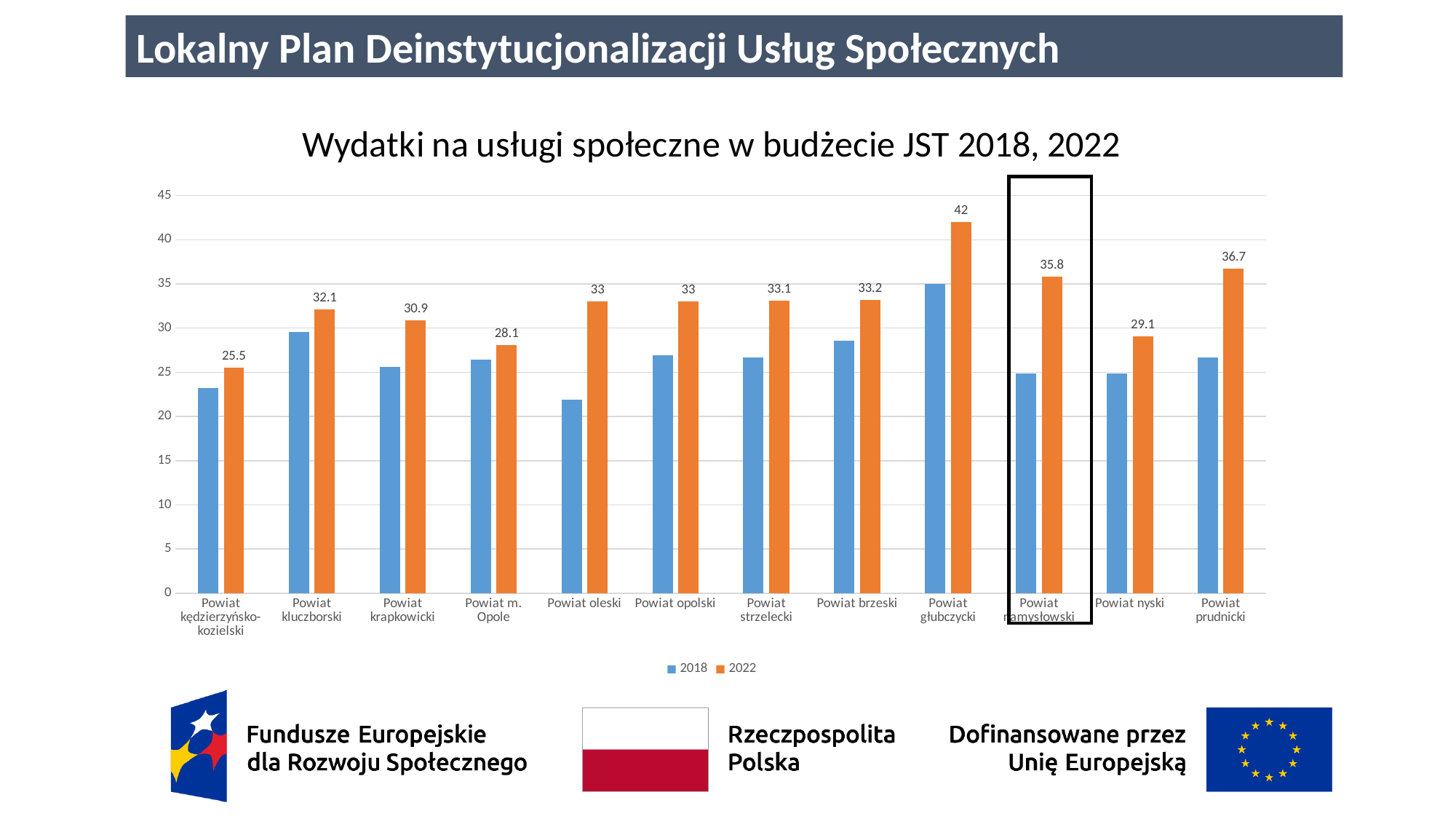
What is the difference between the 2022 values for Powiat prudnicki and Powiat nyski? 7.6 What is the 2022 value for Powiat kędzierzyńsko-kozielski? 25.5 What is the 2022 value for Powiat głubczycki? 42 How many categories (powiats) are shown on the x axis? 12 Which category has the highest 2022 value? Powiat głubczycki Which category has the lowest 2022 value? Powiat kędzierzyńsko-kozielski Which is larger, the 2022 value for Powiat kluczborski or for Powiat krapkowicki? Powiat kluczborski What is the 2022 value for Powiat namysłowski? 35.8 Is the 2018 value for Powiat głubczycki greater or less than 30? greater How many series does the legend list? 2 Is the 2018 value for Powiat oleski greater or less than 25? less What type of chart is shown? bar chart